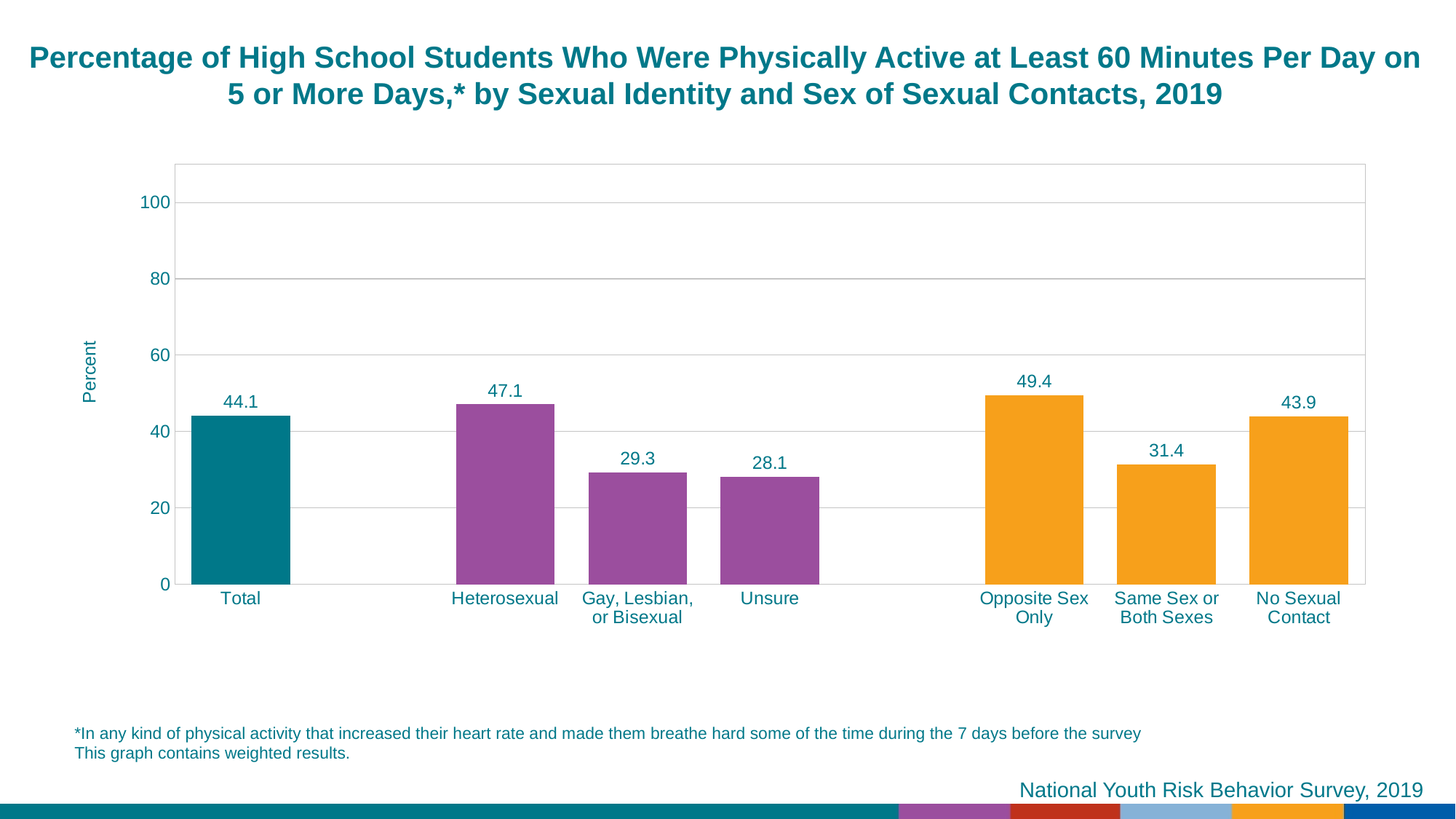
What is the value for students with Same Sex or Both Sexes sexual contacts? 31.4 What kind of chart is shown on the slide? Bar chart What is the value for Heterosexual students? 47.1 What is the value for Total? 44.1 Is the value for Gay, Lesbian, or Bisexual greater or less than 40? less What is the value for Gay, Lesbian, or Bisexual students? 29.3 What is the difference between the values for Opposite Sex Only and No Sexual Contact? 5.5 Which category has the highest value? Opposite Sex Only Which category has the lowest value? Unsure What is the difference between the values for Heterosexual and Unsure? 19.0 Which is larger, the value for Total or the value for No Sexual Contact? Total How many categories are shown in the chart? 7